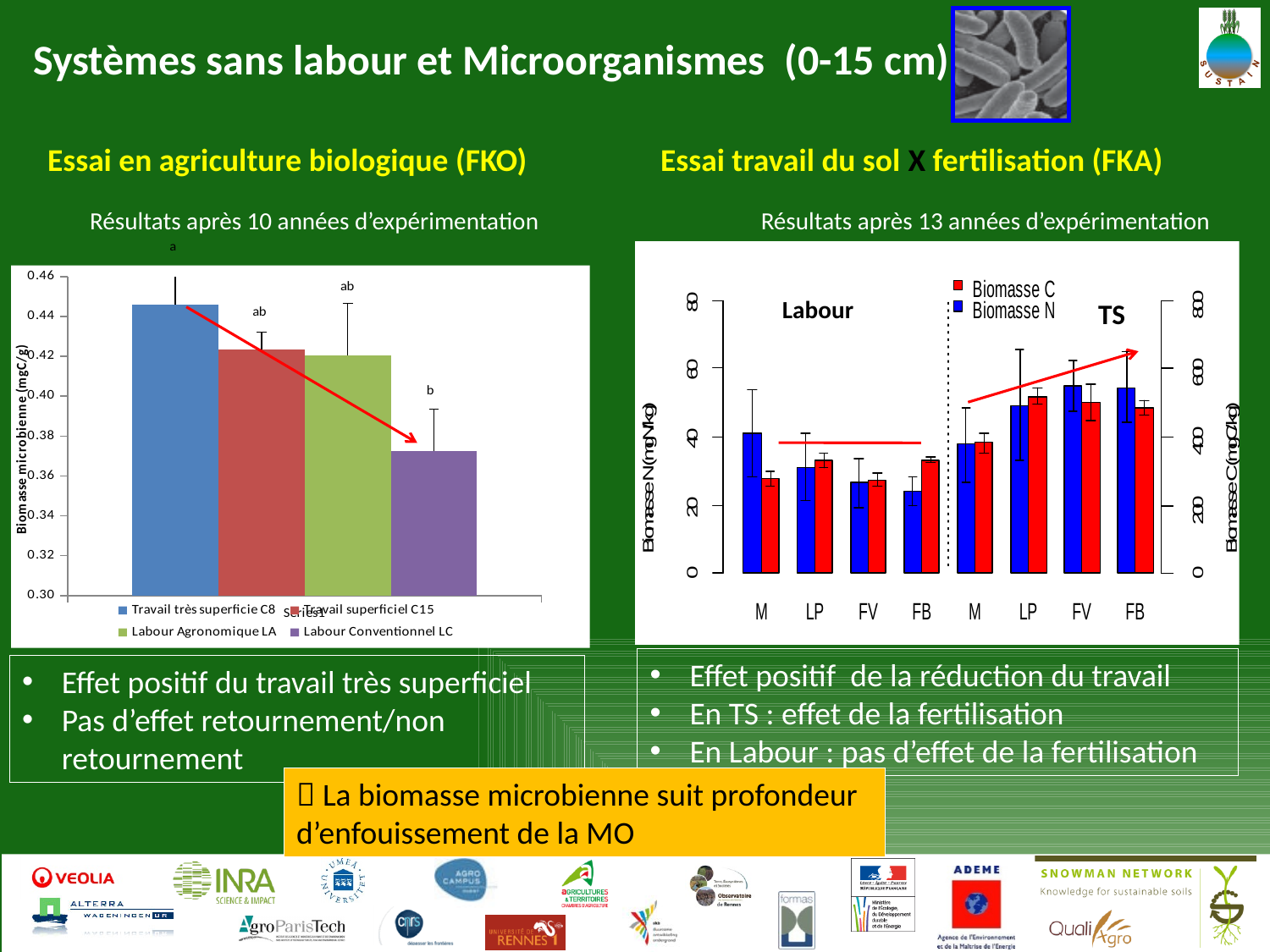
In the left chart, which treatment has the lowest microbial biomass? Labour Conventionnel LC How many series does the legend of the left chart list? 4 In the left chart, which treatment has the highest microbial biomass? Travail très superficie C8 What is the y-axis label of the left chart? Biomasse microbienne (mgC/g) In the left chart, is the value for Travail très superficie C8 greater or less than 0.44? greater What kind of chart is the left chart (Essai en agriculture biologique, FKO)? bar chart How many series does the legend of the right chart (Essai travail du sol X fertilisation, FKA) list? 2 In the right chart, which colour represents Biomasse C? red In the right chart, is the Biomasse N value for FB under Labour greater or less than 40? less In the right chart, is the Biomasse N value for FV under TS greater or less than 40? greater How many category groups are shown along the x axis of the right chart? 8